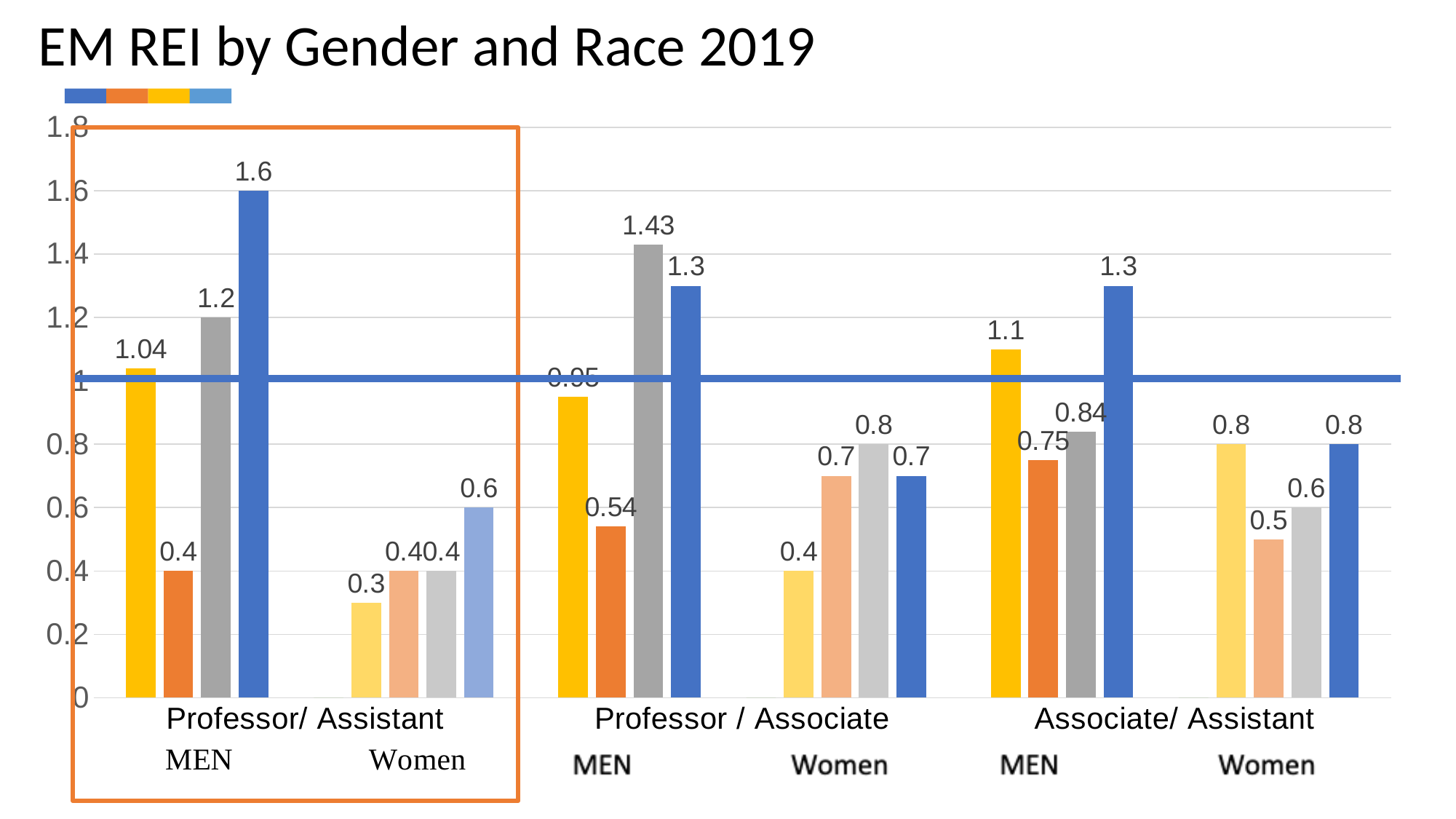
What is the value of the yellow bar for Women in the Professor/ Assistant group? 0.3 What is the value of the yellow bar for MEN in the Professor/ Assistant group? 1.04 What is the title of the chart? EM REI by Gender and Race 2019 Which bar has the lowest value in the whole chart? the yellow bar for Women in Professor/ Assistant (0.3) What is the difference between the dark blue bar for MEN (1.6) and the dark blue bar for Women (0.6) in the Professor/ Assistant group? 1 What is the value of the dark blue bar for MEN in the Professor/ Assistant group? 1.6 What is the value of the gray bar for MEN in the Professor / Associate group? 1.43 How many colour swatches does the legend show? 4 What is the value of the orange bar for MEN in the Associate/ Assistant group? 0.75 Which bar has the highest value in the whole chart? the dark blue bar for MEN in Professor/ Assistant (1.6) What kind of chart is shown on the slide? bar chart In the Professor / Associate group, which is larger for MEN: the gray bar or the dark blue bar? the gray bar